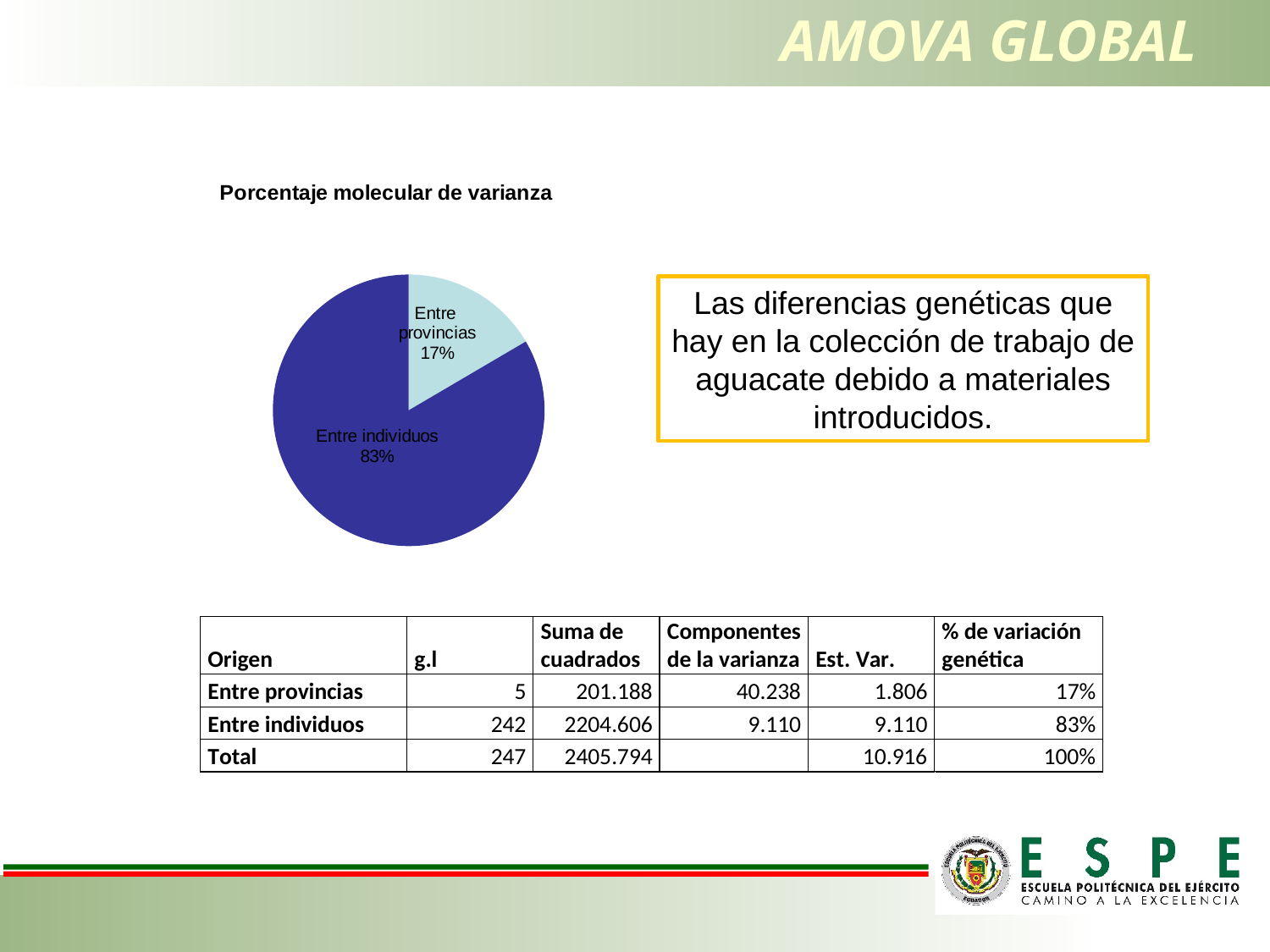
What share of the pie does 'Entre provincias' represent? 17% Which slice of the pie is the largest? Entre individuos What percentage does the 'Entre provincias' slice show? 17% What is the title of the chart? Porcentaje molecular de varianza What kind of chart is shown on the slide? pie chart Which is larger, the 'Entre provincias' slice or the 'Entre individuos' slice? Entre individuos What percentage does the 'Entre individuos' slice show? 83% What colour is the 'Entre individuos' slice? dark blue What is the difference in percentage points between the 'Entre individuos' and 'Entre provincias' slices? 66 How many slices does the pie chart have? 2 Which slice of the pie is the smallest? Entre provincias